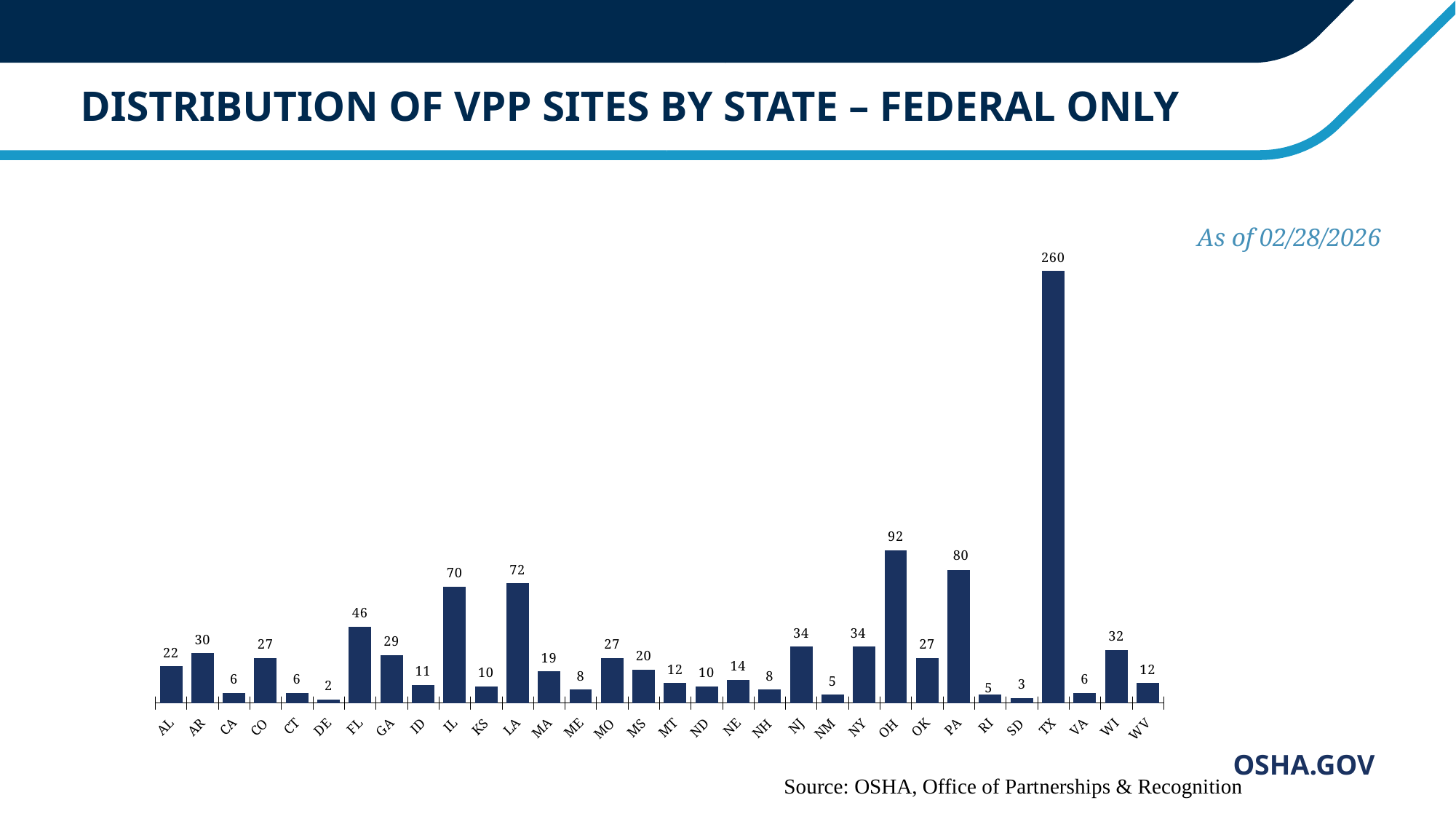
Which state has the highest value? TX What is the difference between the values for LA and IL? 2 What is the difference between the values for TX and OH? 168 What is the value for OH? 92 What is the value for TX? 260 Which state has the lowest value? DE What is the 'as of' date shown on the slide? 02/28/2026 What is the value for FL? 46 Which is larger, the value for PA or the value for OH? OH What kind of chart is this? Bar chart How many states are shown on the x axis? 32 Which is larger, the value for AR or the value for WI? WI